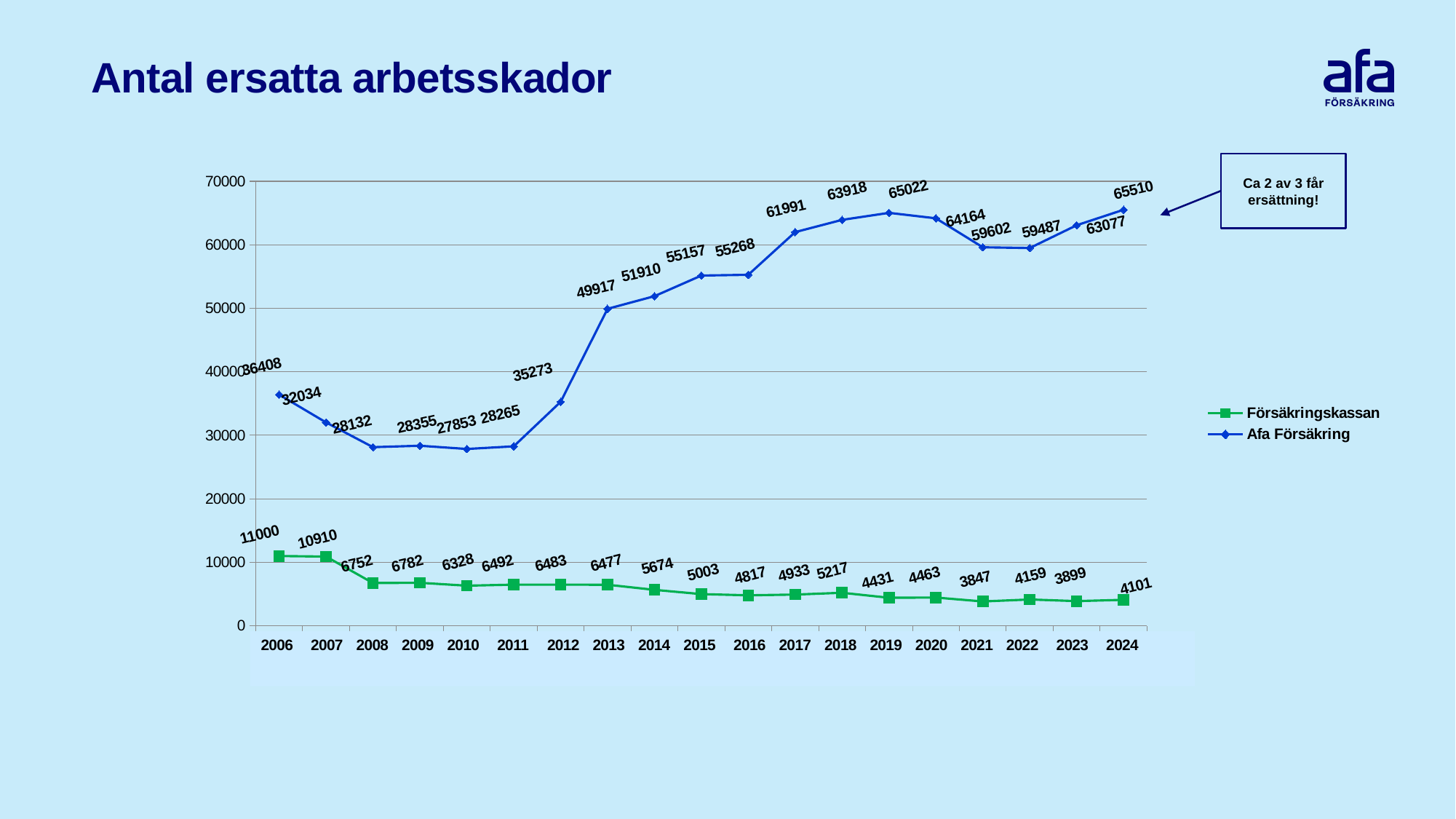
Which series has the larger value in 2012, Afa Försäkring or Försäkringskassan? Afa Försäkring How many years are plotted along the x axis? 19 What is the difference between the Afa Försäkring and Försäkringskassan values in 2024? 61409 In which year is the Afa Försäkring value highest? 2024 What is the title of the chart? Antal ersatta arbetsskador What is the value for Afa Försäkring in 2024? 65510 What is the value for Afa Försäkring in 2013? 49917 What type of chart is shown on the slide? Line chart What is the value for Försäkringskassan in 2006? 11000 In which year is the Afa Försäkring value lowest? 2010 In which year is the Försäkringskassan value lowest? 2021 How many series does the legend list? 2